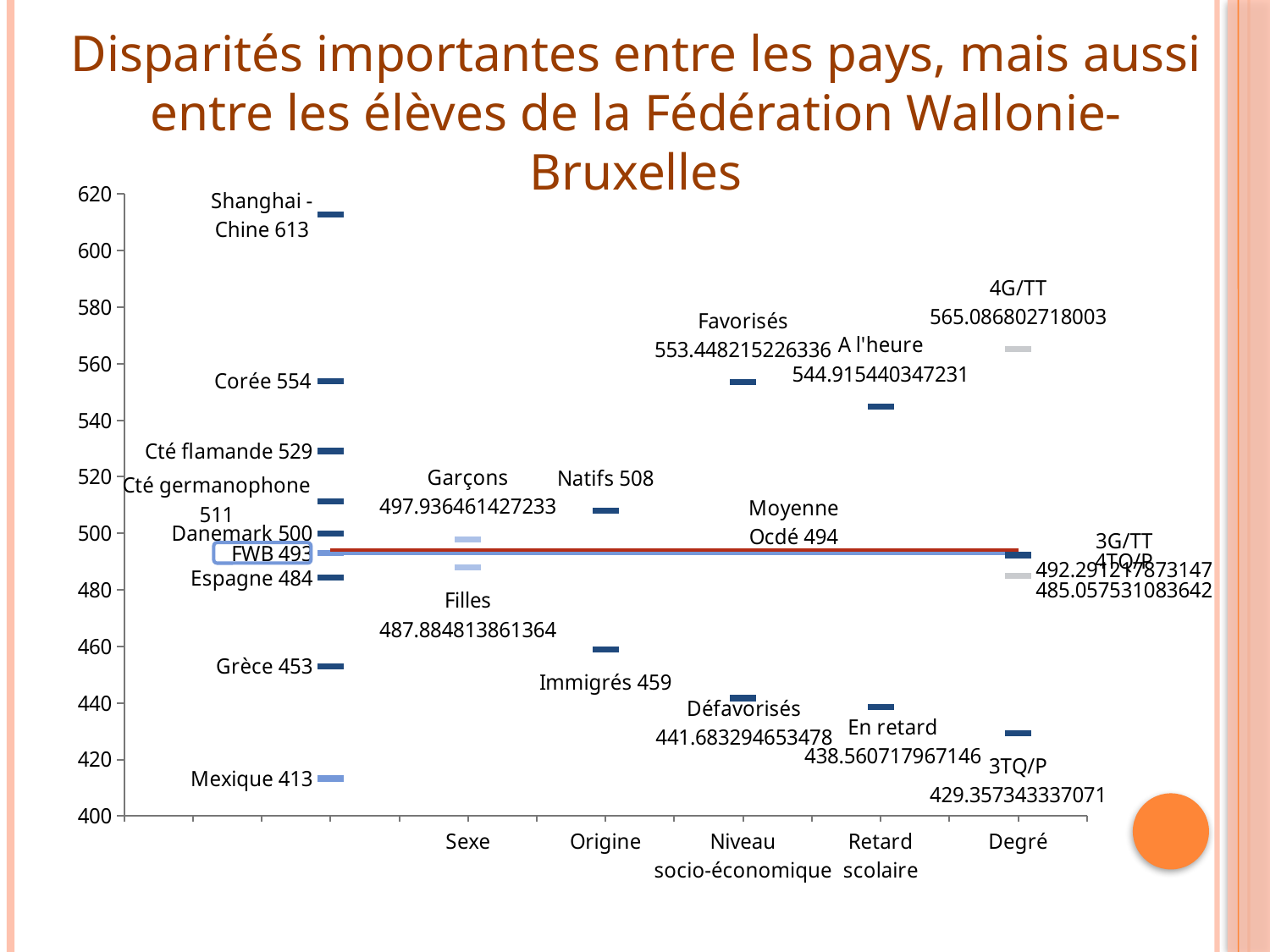
What is the difference between the values for Corée and Grèce? 101 What is the value shown for Mexique? 413 How many categories are labelled along the x axis? 5 Which country or region has the lowest value on the chart? Mexique What is the value shown for Natifs? 508 Which is larger, the value for Natifs or the value for Immigrés? Natifs What is the value shown for Shanghai - Chine? 613 What is the value shown for FWB? 493 Which country or region has the highest value on the chart? Shanghai - Chine What is the value shown for Moyenne Ocdé? 494 Is the value for Favorisés greater or less than 540? greater What is the difference between the values for Cté flamande and FWB? 36